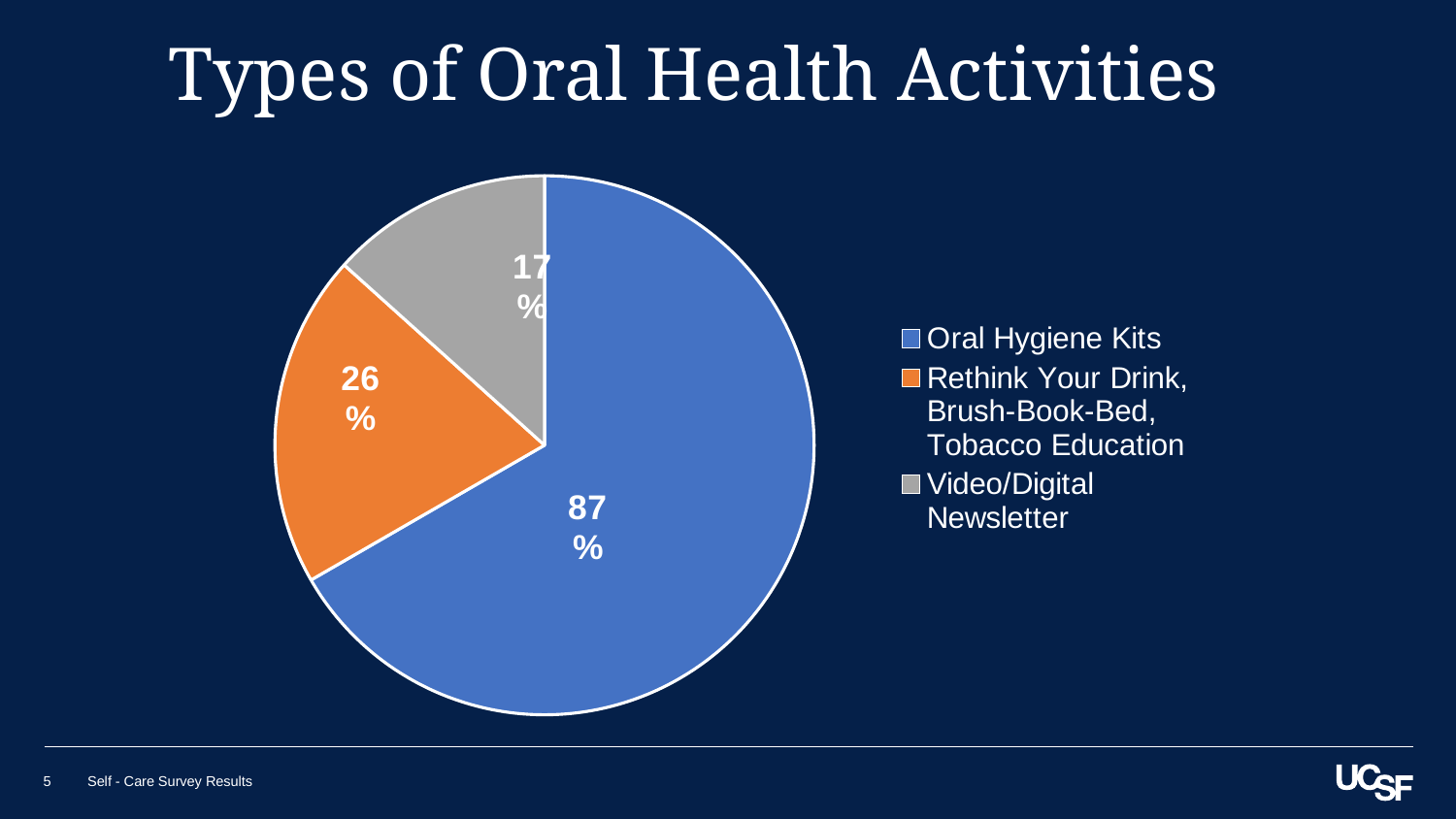
How many categories does the pie chart show? 3 How many entries does the legend list? 3 Which category has the largest slice of the pie? Oral Hygiene Kits What is the difference between the labelled values for Oral Hygiene Kits and Video/Digital Newsletter? 70% What value is labelled on the Rethink Your Drink, Brush-Book-Bed, Tobacco Education slice? 26% What kind of chart is shown on the slide? Pie chart What is the title of the chart? Types of Oral Health Activities Which category has the smallest slice of the pie? Video/Digital Newsletter What value is labelled on the Video/Digital Newsletter slice? 17% What value is labelled on the Oral Hygiene Kits slice? 87% What colour is the Video/Digital Newsletter slice? Gray Which has the larger labelled value: Rethink Your Drink, Brush-Book-Bed, Tobacco Education or Video/Digital Newsletter? Rethink Your Drink, Brush-Book-Bed, Tobacco Education